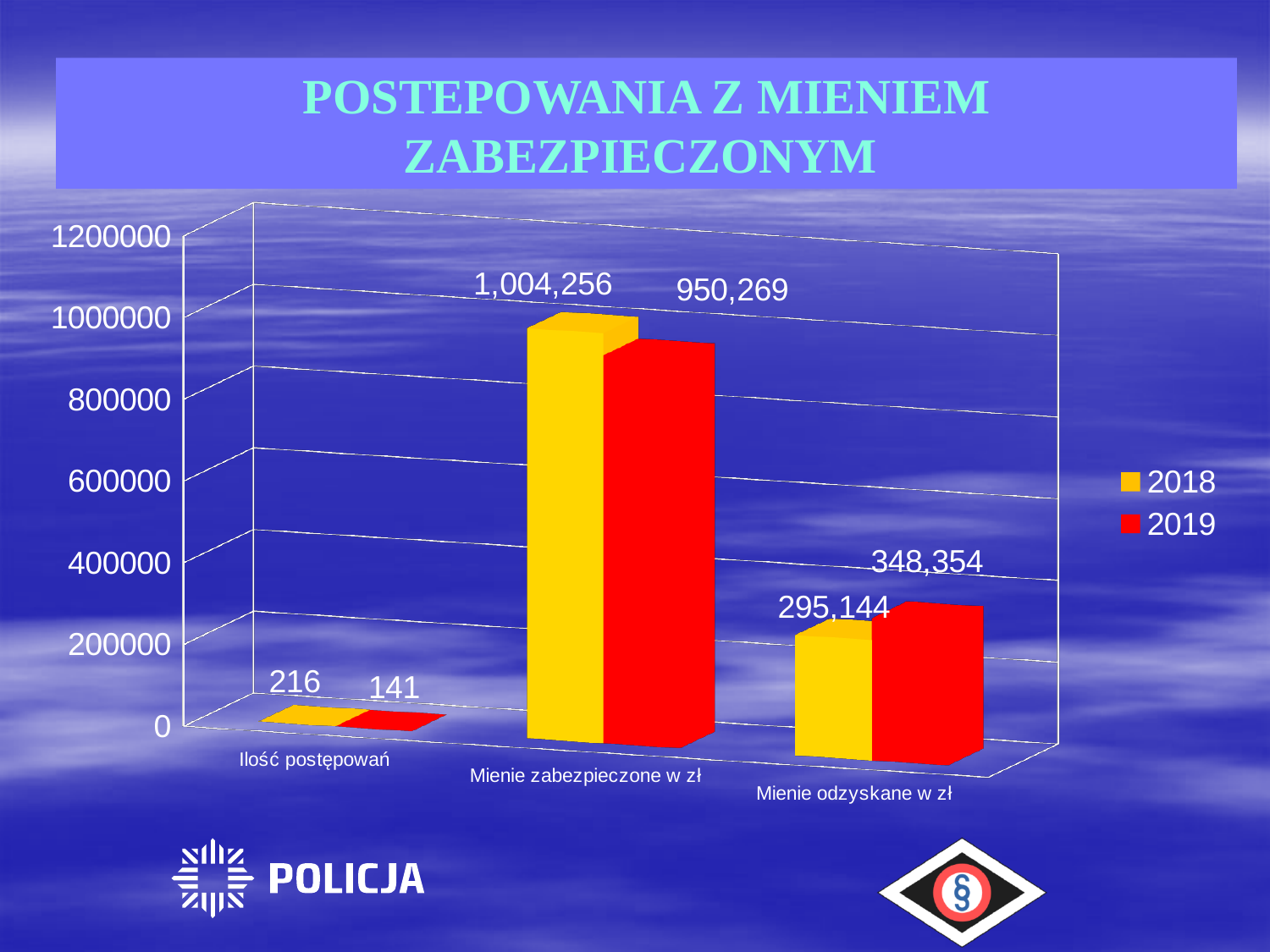
Which is larger for 'Mienie odzyskane w zł': the 2018 value or the 2019 value? 2019 How many categories are shown on the x axis? 3 Is the 2019 value for 'Mienie zabezpieczone w zł' greater or less than 800000? greater What is the value for 2019 in the 'Mienie odzyskane w zł' category? 348,354 What is the value for 2019 in the 'Ilość postępowań' category? 141 How many series does the legend list? 2 Which category has the highest value for the 2019 series? Mienie zabezpieczone w zł Which category has the lowest value for the 2018 series? Ilość postępowań What is the value for 2018 in the 'Mienie zabezpieczone w zł' category? 1,004,256 What kind of chart is shown on the slide? Bar chart What is the difference between the 2018 and 2019 values for 'Mienie zabezpieczone w zł'? 53,987 What is the value for 2018 in the 'Mienie odzyskane w zł' category? 295,144